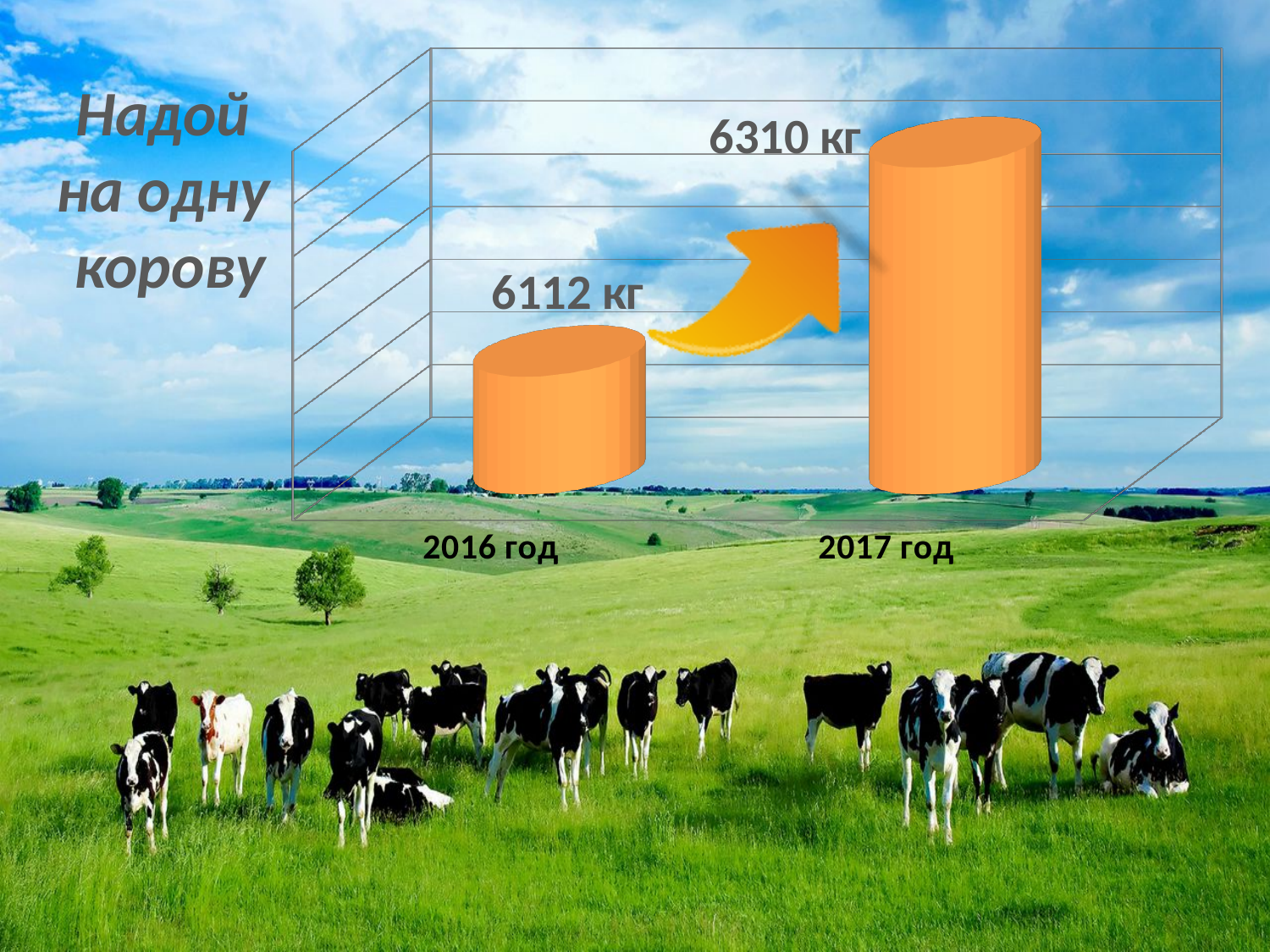
Which year has the highest value? 2017 год What is the title of the chart? Надой на одну корову What is the difference between the values for 2017 год and 2016 год? 198 кг How many categories are shown on the chart? 2 What kind of chart is shown on the slide? bar chart What is the value for 2016 год? 6112 кг What colour are the bars in the chart? orange What is the value for 2017 год? 6310 кг Which is larger, the value for 2016 год or the value for 2017 год? 2017 год Do the values rise or fall from 2016 год to 2017 год? rise Which year has the lowest value? 2016 год